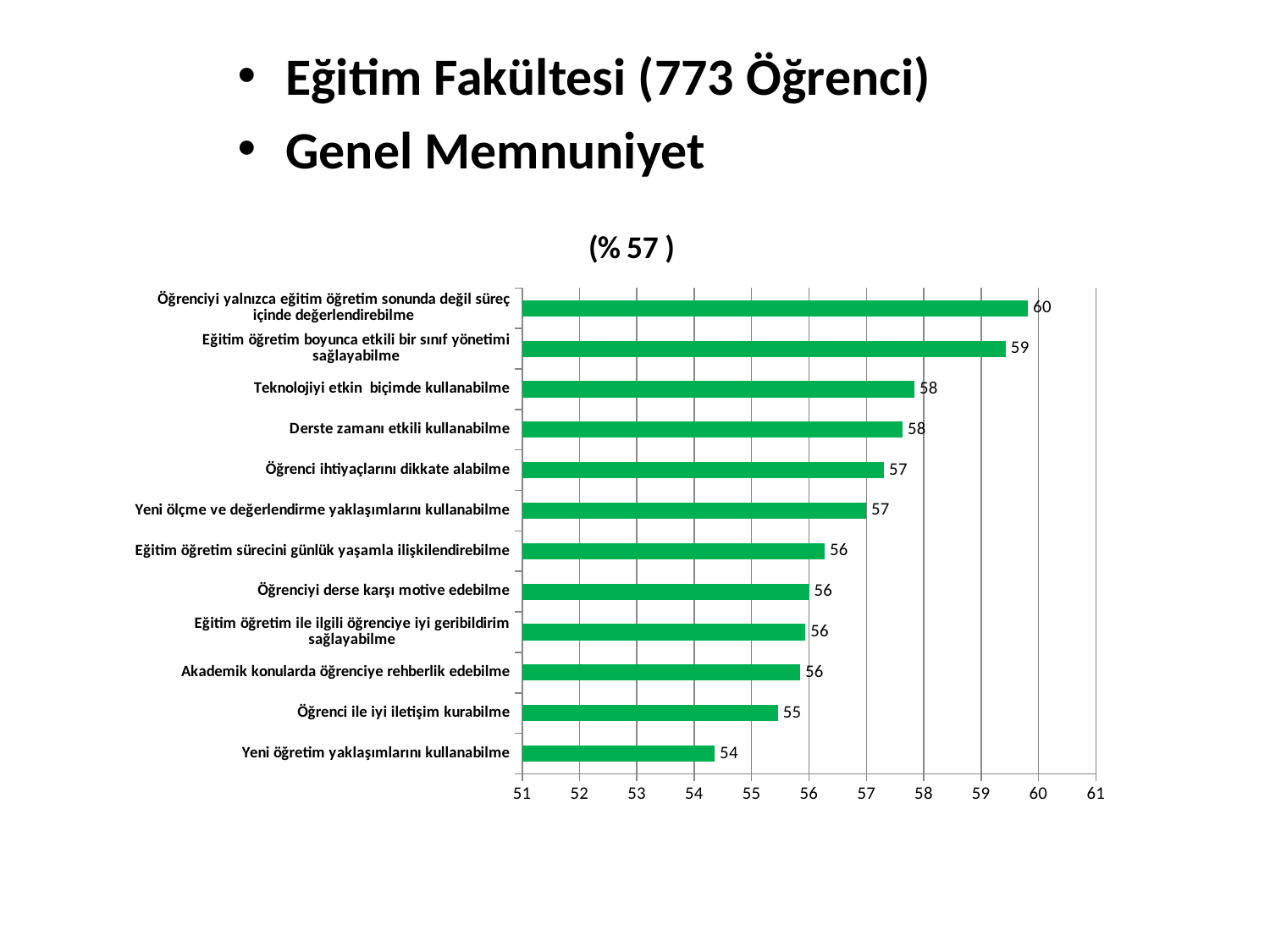
What is the difference between the highest value (60) and the lowest value (54)? 6 What kind of chart is shown on the slide? Bar chart What is the difference between "Eğitim öğretim boyunca etkili bir sınıf yönetimi sağlayabilme" and "Öğrenci ile iyi iletişim kurabilme"? 4 Which category has the highest value? Öğrenciyi yalnızca eğitim öğretim sonunda değil süreç içinde değerlendirebilme What is the value for "Eğitim öğretim boyunca etkili bir sınıf yönetimi sağlayabilme"? 59 What is the title of the chart? (% 57 ) How many categories are shown in the chart? 12 What is the value for "Teknolojiyi etkin biçimde kullanabilme"? 58 Which is larger: the value for "Öğrenci ihtiyaçlarını dikkate alabilme" or the value for "Yeni öğretim yaklaşımlarını kullanabilme"? Öğrenci ihtiyaçlarını dikkate alabilme What is the value for "Öğrenci ile iyi iletişim kurabilme"? 55 Which category has the lowest value? Yeni öğretim yaklaşımlarını kullanabilme What is the value for "Yeni öğretim yaklaşımlarını kullanabilme"? 54